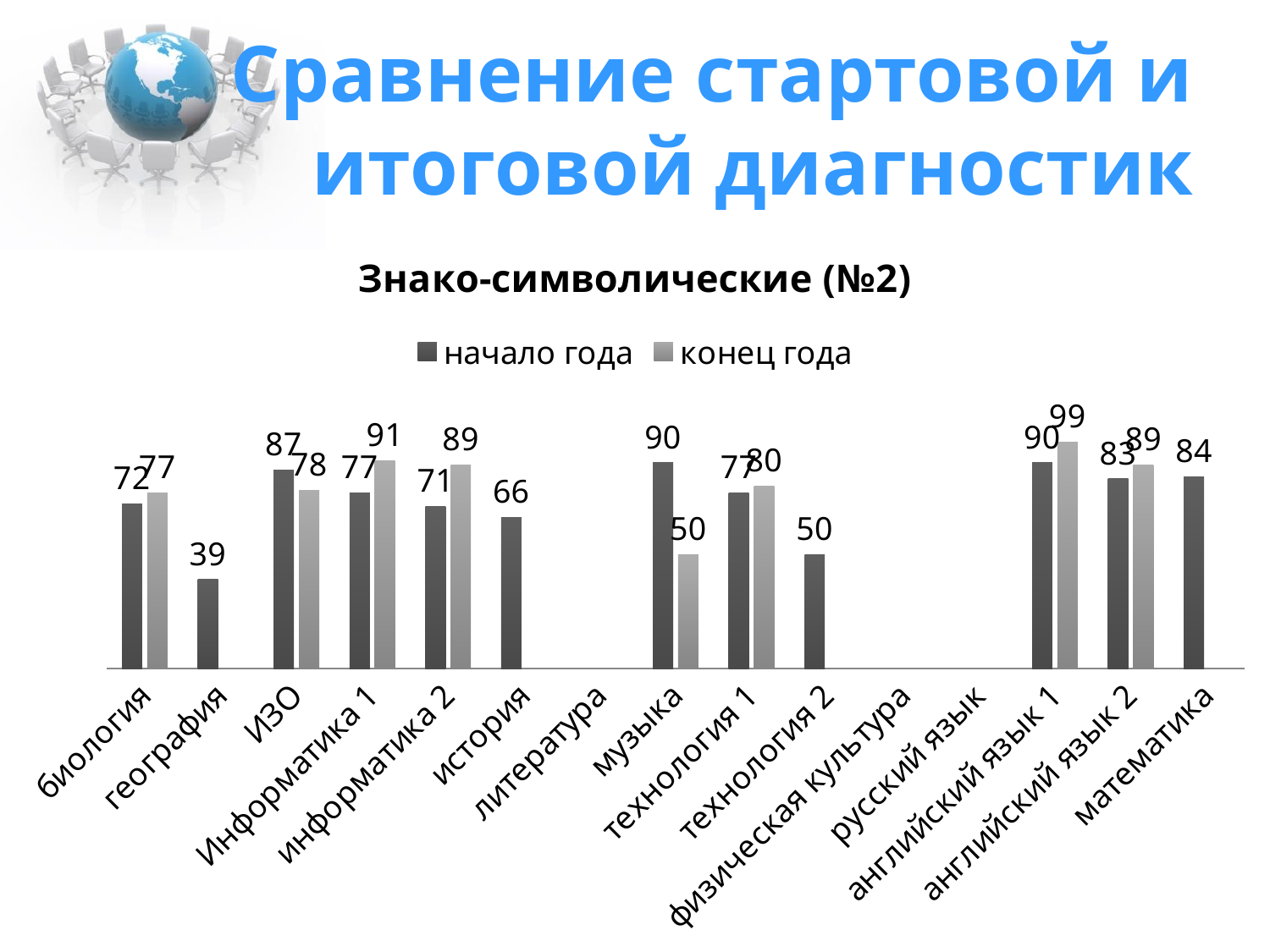
Which category has the lowest "начало года" value? география For ИЗО, which is larger: "начало года" or "конец года"? начало года What is the difference between the "конец года" and "начало года" values for английский язык 1? 9 Which category has the highest "конец года" value? английский язык 1 How many categories are shown on the x axis? 15 What is the value of "начало года" for биология? 72 What is the value of "конец года" for Информатика 1? 91 What is the value of "начало года" for математика? 84 How many series does the legend list? 2 What kind of chart is shown on the slide? bar chart What is the title of the chart? Знако-символические (№2) What is the difference between the "начало года" and "конец года" values for музыка? 40